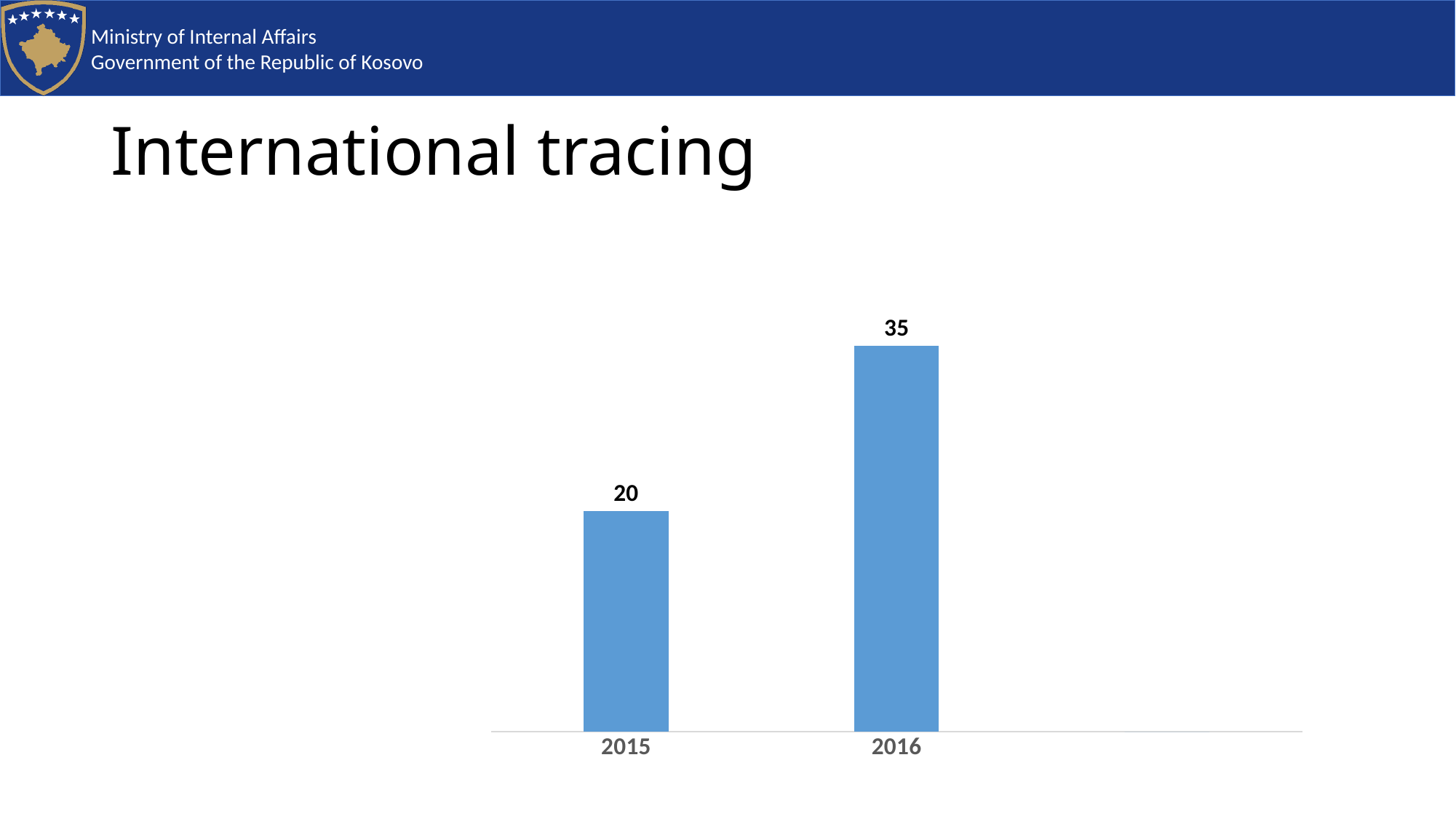
What is the value for 2015? 20 What is the title of the slide containing the chart? International tracing Which is larger, the value for 2015 or the value for 2016? 2016 What is the total of the values for 2015 and 2016? 55 How many years are shown in the chart? 2 Do the values rise or fall from 2015 to 2016? Rise Which year has the lowest value? 2015 What is the difference between the values for 2016 and 2015? 15 What kind of chart is shown on the slide? Bar chart What is the value for 2016? 35 What colour are the bars in the chart? Blue Which year has the highest value? 2016